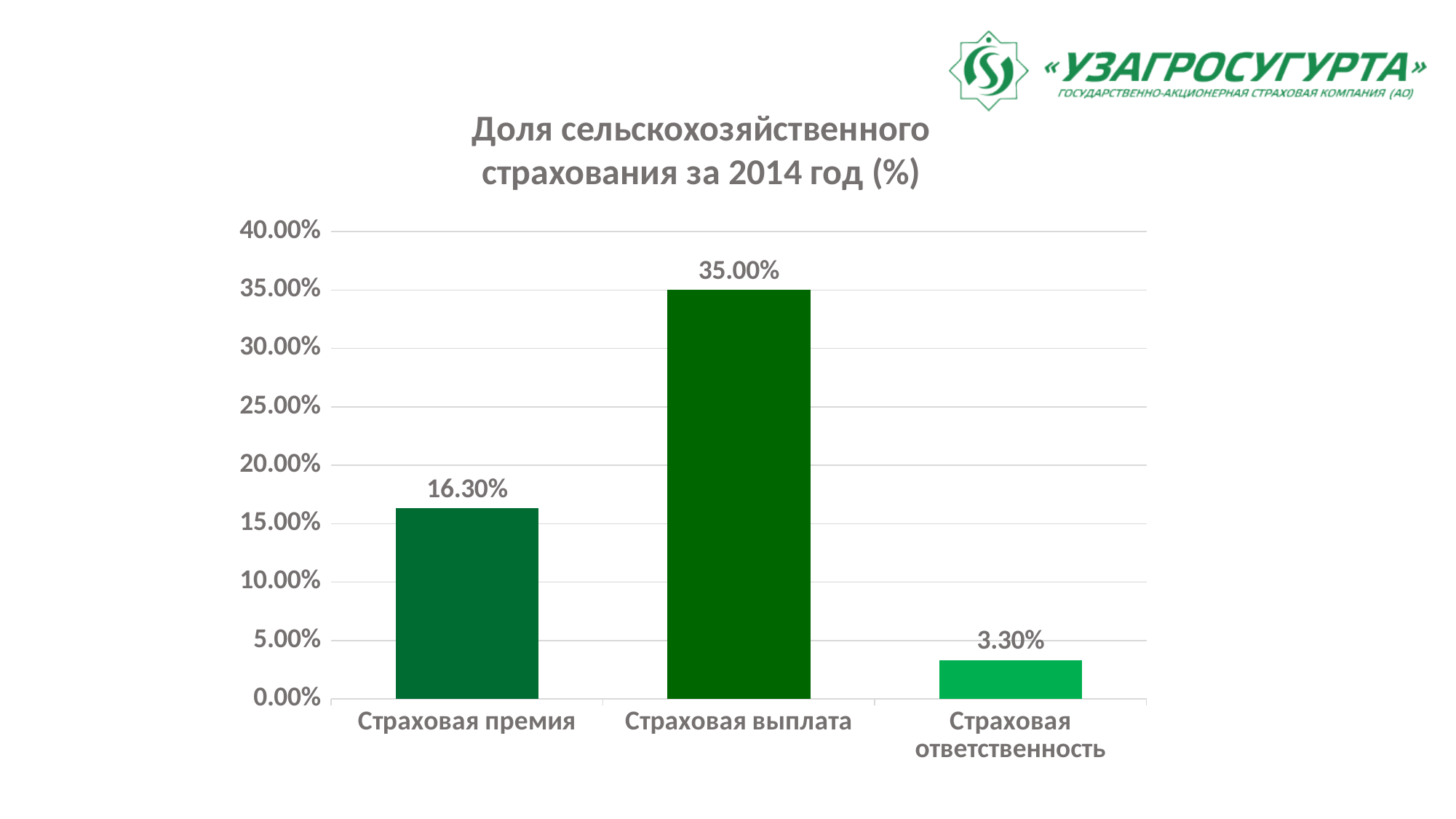
What is the difference between the values for Страховая премия and Страховая ответственность? 13.00% Which category has the lowest value? Страховая ответственность What is the difference between the values for Страховая выплата and Страховая премия? 18.70% What is the value for Страховая выплата? 35.00% Is the value for Страховая премия greater or less than 20.00%? less What is the title of the chart? Доля сельскохозяйственного страхования за 2014 год (%) Which is larger, the value for Страховая премия or the value for Страховая ответственность? Страховая премия What kind of chart is shown on the slide? bar chart What is the value for Страховая премия? 16.30% How many categories are shown in the chart? 3 What is the value for Страховая ответственность? 3.30% Which category has the highest value? Страховая выплата